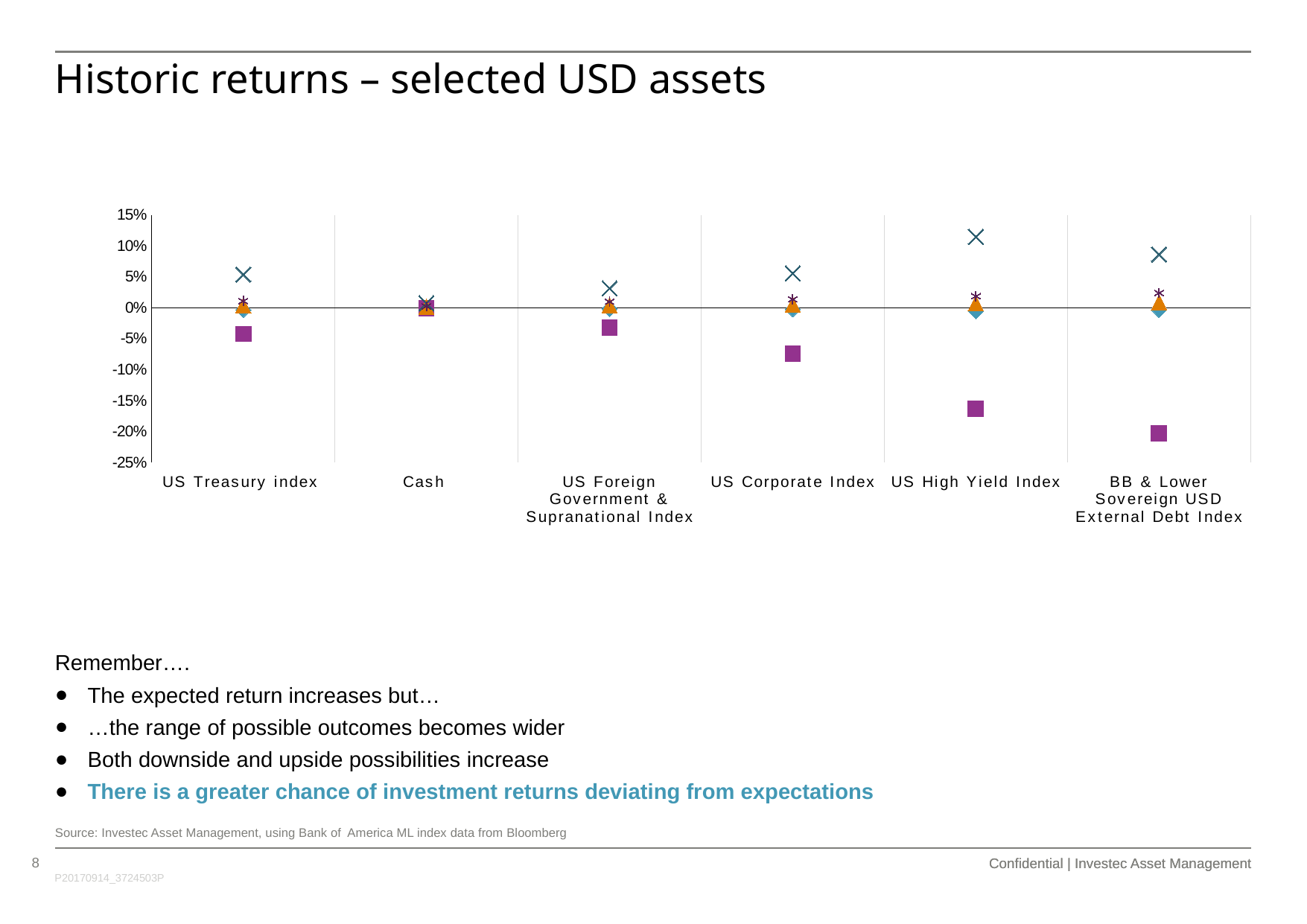
Which category has the highest X marker? US High Yield Index What kind of chart is shown on the slide? scatter chart What is the highest value shown on the chart's y axis? 15% Is the purple square marker for BB & Lower Sovereign USD External Debt Index greater or less than -15%? less Is the X marker for BB & Lower Sovereign USD External Debt Index greater or less than 5%? greater What is the title of the slide containing the chart? Historic returns – selected USD assets Which category has the lowest purple square marker? BB & Lower Sovereign USD External Debt Index Which has the lower purple square marker, US Treasury index or US Corporate Index? US Corporate Index Is the purple square marker for US High Yield Index greater or less than -10%? less How many asset categories are shown on the x axis of the chart? 6